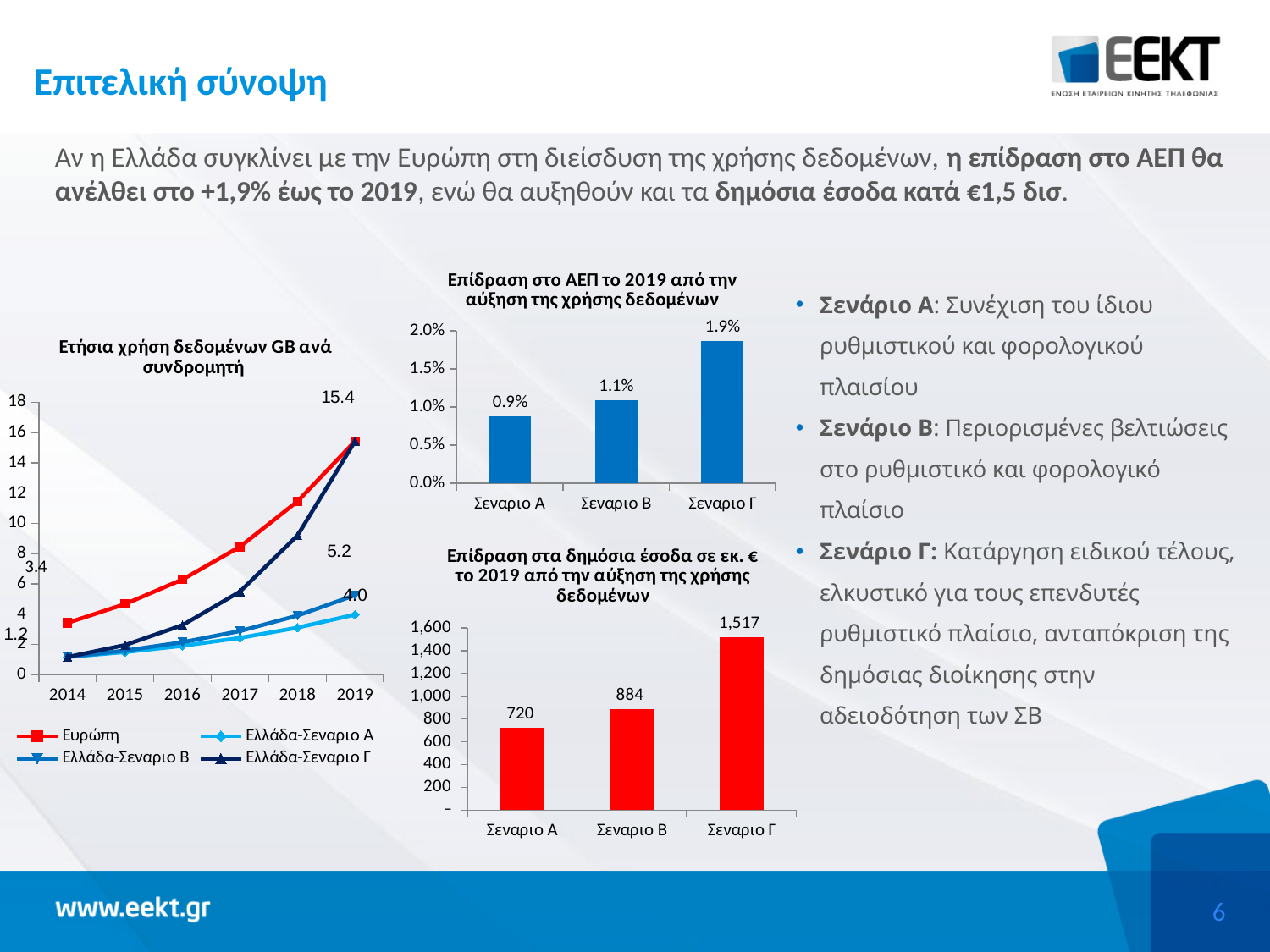
In the chart titled 'Επίδραση στο ΑΕΠ το 2019 από την αύξηση της χρήσης δεδομένων', what is the difference between Σεναριο Γ and Σεναριο Β? 0.8% In the chart titled 'Ετήσια χρήση δεδομένων GB ανά συνδρομητή', how many series does the legend list? 4 In the chart titled 'Επίδραση στο ΑΕΠ το 2019 από την αύξηση της χρήσης δεδομένων', which scenario has the lowest value? Σεναριο Α In the chart titled 'Επίδραση στο ΑΕΠ το 2019 από την αύξηση της χρήσης δεδομένων', what is the value for Σεναριο Α? 0.9% In the chart titled 'Επίδραση στο ΑΕΠ το 2019 από την αύξηση της χρήσης δεδομένων', what is the value for Σεναριο Γ? 1.9% What kind of chart is the one titled 'Επίδραση στα δημόσια έσοδα σε εκ. € το 2019 από την αύξηση της χρήσης δεδομένων'? Bar chart In the chart titled 'Ετήσια χρήση δεδομένων GB ανά συνδρομητή', is the value for Ελλάδα-Σεναριο Α in 2019 greater or less than 6? less In the chart titled 'Επίδραση στα δημόσια έσοδα σε εκ. € το 2019 από την αύξηση της χρήσης δεδομένων', how many scenarios are shown on the x axis? 3 In the chart titled 'Επίδραση στα δημόσια έσοδα σε εκ. € το 2019 από την αύξηση της χρήσης δεδομένων', what is the difference between Σεναριο Γ and Σεναριο Α? 797 In the chart titled 'Επίδραση στα δημόσια έσοδα σε εκ. € το 2019 από την αύξηση της χρήσης δεδομένων', what is the value for Σεναριο Β? 884 In the chart titled 'Ετήσια χρήση δεδομένων GB ανά συνδρομητή', does the Ευρώπη series rise or fall from 2014 to 2019? Rise In the chart titled 'Επίδραση στα δημόσια έσοδα σε εκ. € το 2019 από την αύξηση της χρήσης δεδομένων', which scenario has the highest value? Σεναριο Γ